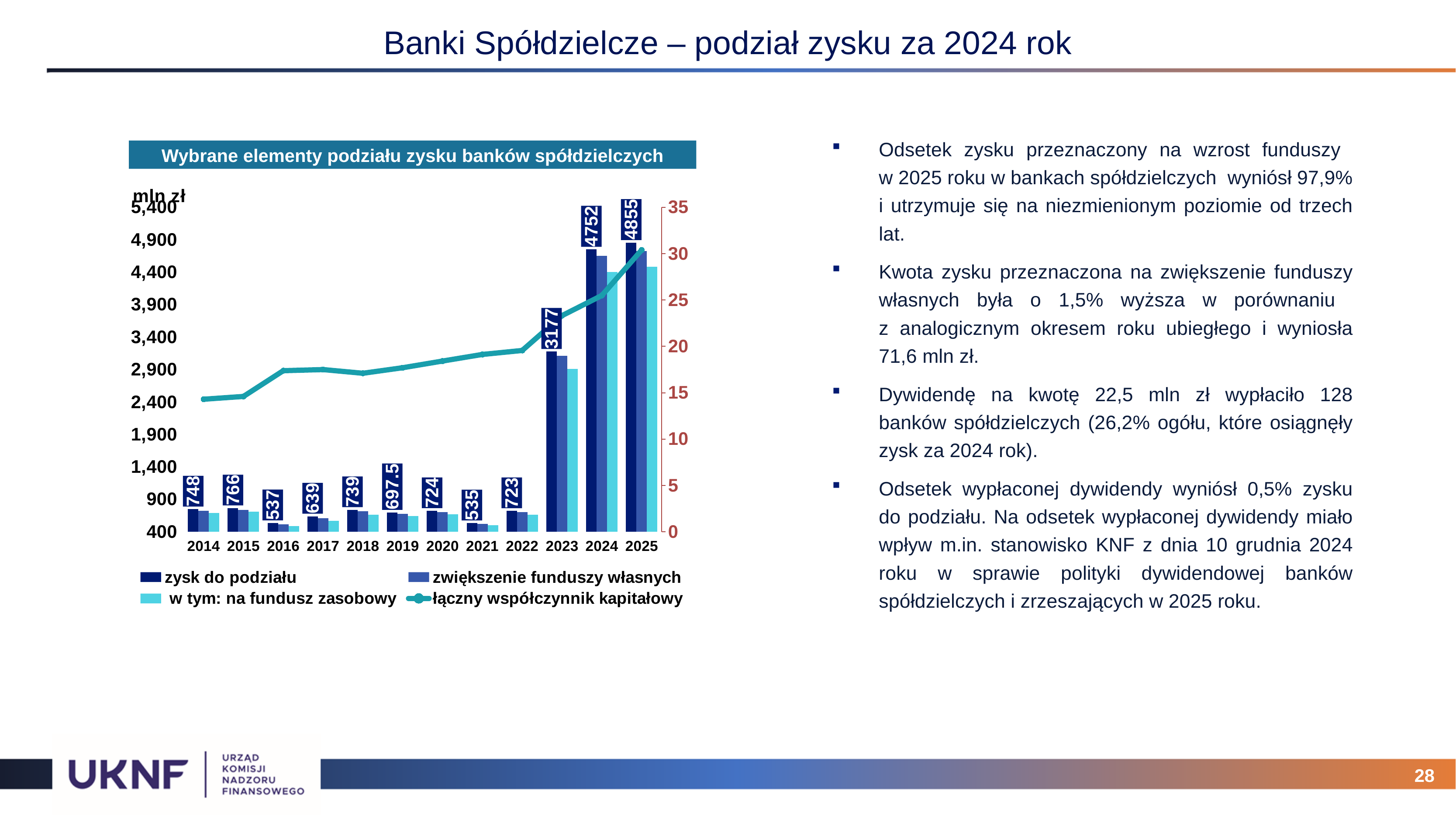
Which year has the highest value of 'zysk do podziału'? 2025 What is the value of 'zysk do podziału' for 2025? 4855 Is the value of 'łączny współczynnik kapitałowy' for 2014 greater or less than 15? less Which year has the lowest value of 'zysk do podziału'? 2021 What is the value of 'zysk do podziału' for 2019? 697.5 Is the value of 'łączny współczynnik kapitałowy' for 2024 greater or less than 20? greater How many series does the chart legend list? 4 How many years are shown on the x axis of the chart? 12 What is the difference between the 'zysk do podziału' values for 2025 and 2024? 103 What is the value of 'zysk do podziału' for 2014? 748 Does the 'łączny współczynnik kapitałowy' line generally rise or fall from 2014 to 2025? rise Which year has a larger 'zysk do podziału' value, 2015 or 2016? 2015